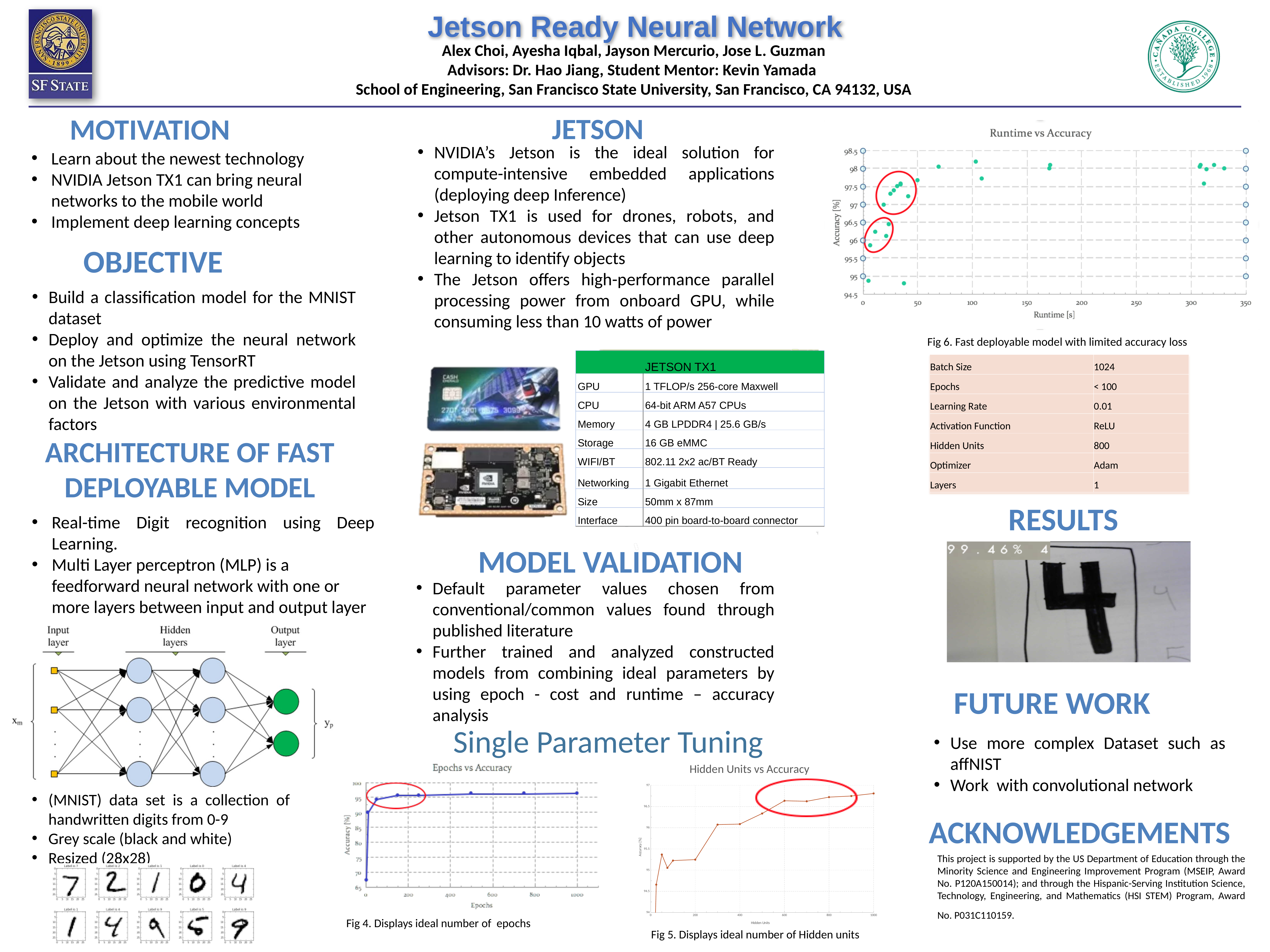
What kind of chart is the 'Epochs vs Accuracy' chart? line chart In the 'Epochs vs Accuracy' chart, is the accuracy at 1000 epochs greater or less than 90? greater What is the x-axis label of the 'Runtime vs Accuracy' chart? Runtime [s] In the 'Hidden Units vs Accuracy' chart, does accuracy generally rise or fall as the number of hidden units increases? rise In the 'Epochs vs Accuracy' chart, is the accuracy at 0 epochs greater or less than 75? less What kind of chart is the 'Hidden Units vs Accuracy' chart? line chart In the 'Epochs vs Accuracy' chart, does accuracy rise or fall as the number of epochs increases? rise What kind of chart is the 'Runtime vs Accuracy' chart? scatter plot In the 'Hidden Units vs Accuracy' chart, is the accuracy at 1000 hidden units greater or less than 96? greater What is the y-axis label of the 'Runtime vs Accuracy' chart? Accuracy [%]